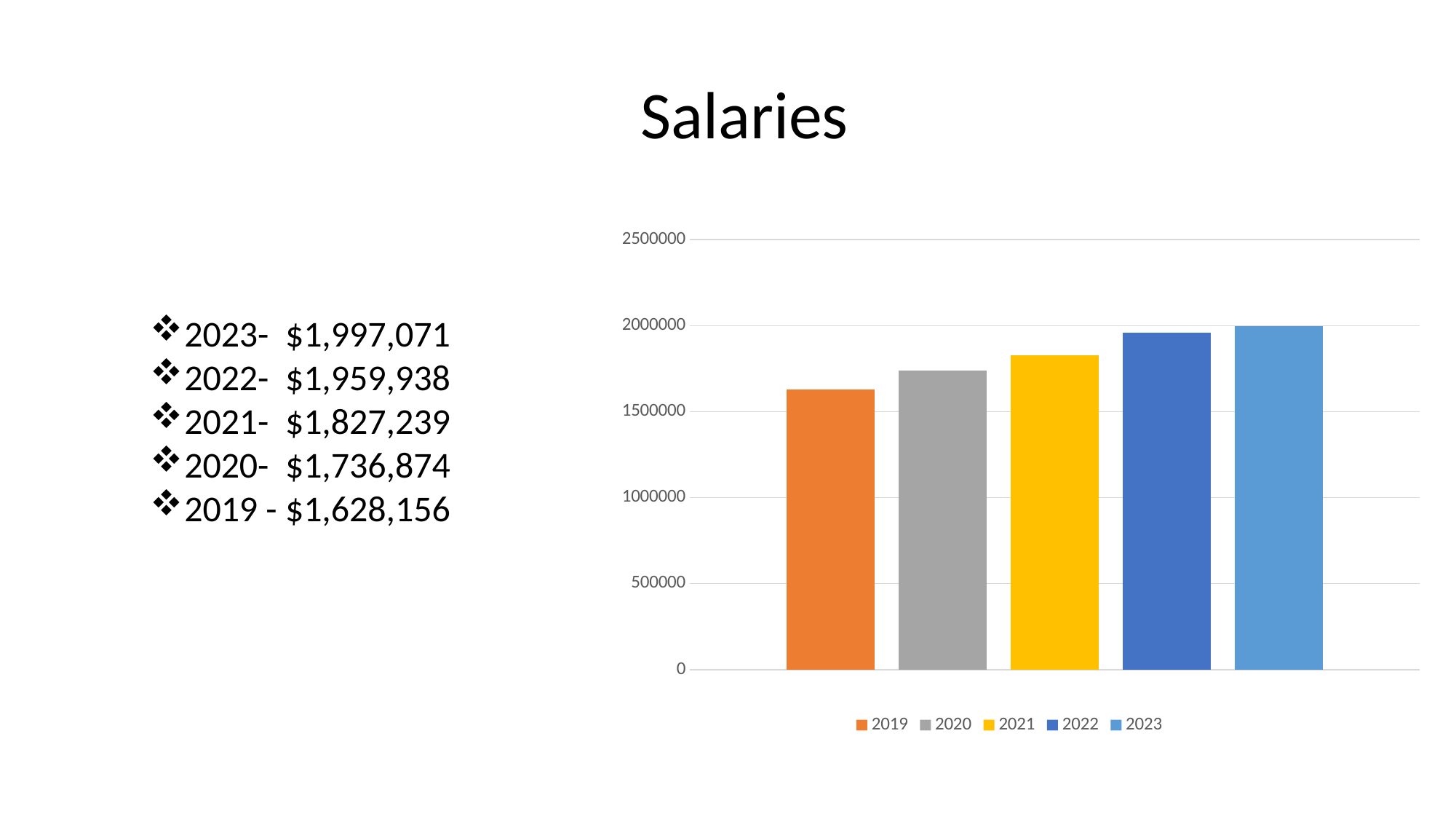
Which is larger, the salary value for 2020 or for 2022? 2022 Which year has the highest salary value in the chart? 2023 What kind of chart is shown on the slide? bar chart Is the value for 2019 greater or less than 2000000? less Do the salary values rise or fall from 2019 to 2023? rise How many entries does the chart's legend list? 5 What is the salary value for 2019? $1,628,156 What is the salary value for 2021? $1,827,239 What is the difference between the 2020 and 2019 salary values? $108,718 Which year has the lowest salary value in the chart? 2019 How many bars are plotted in the chart? 5 What is the difference between the 2023 and 2022 salary values? $37,133